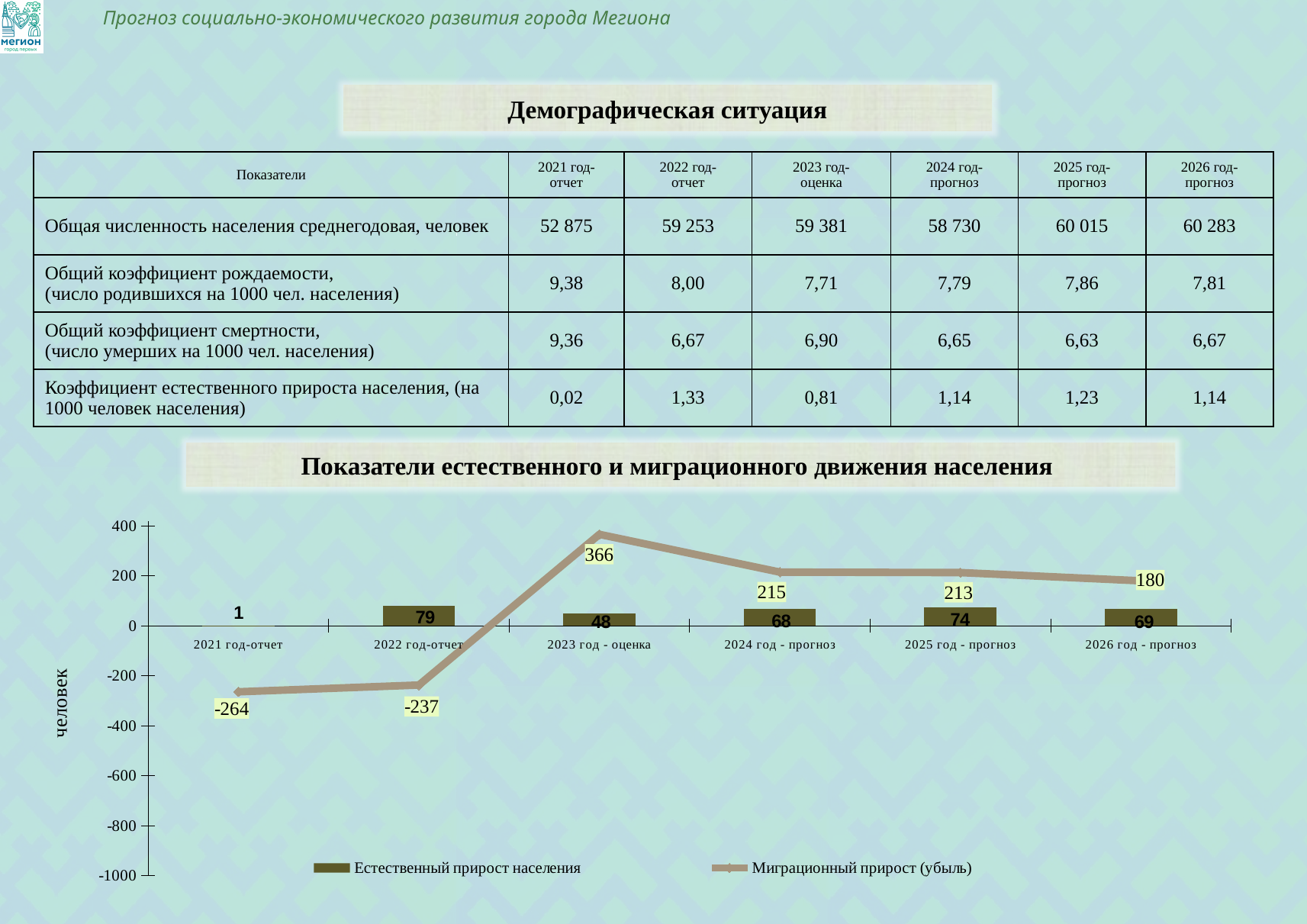
How many series does the chart legend list? 2 In which year is Миграционный прирост (убыль) the highest? 2023 год - оценка How many years (categories) are shown on the x axis of the chart? 6 What is the difference between Миграционный прирост (убыль) in 2024 год - прогноз and 2026 год - прогноз? 35 Which is larger: Естественный прирост населения in 2025 год - прогноз or in 2024 год - прогноз? 2025 год - прогноз What is the value of Естественный прирост населения for 2022 год-отчет? 79 In which year is Естественный прирост населения the lowest? 2021 год-отчет What is the value of Естественный прирост населения for 2026 год - прогноз? 69 What is the value of Миграционный прирост (убыль) for 2021 год-отчет? -264 How does Миграционный прирост (убыль) change from 2023 год - оценка to 2026 год - прогноз? It falls What is the value of Миграционный прирост (убыль) for 2023 год - оценка? 366 What is the title of the chart on the slide? Показатели естественного и миграционного движения населения